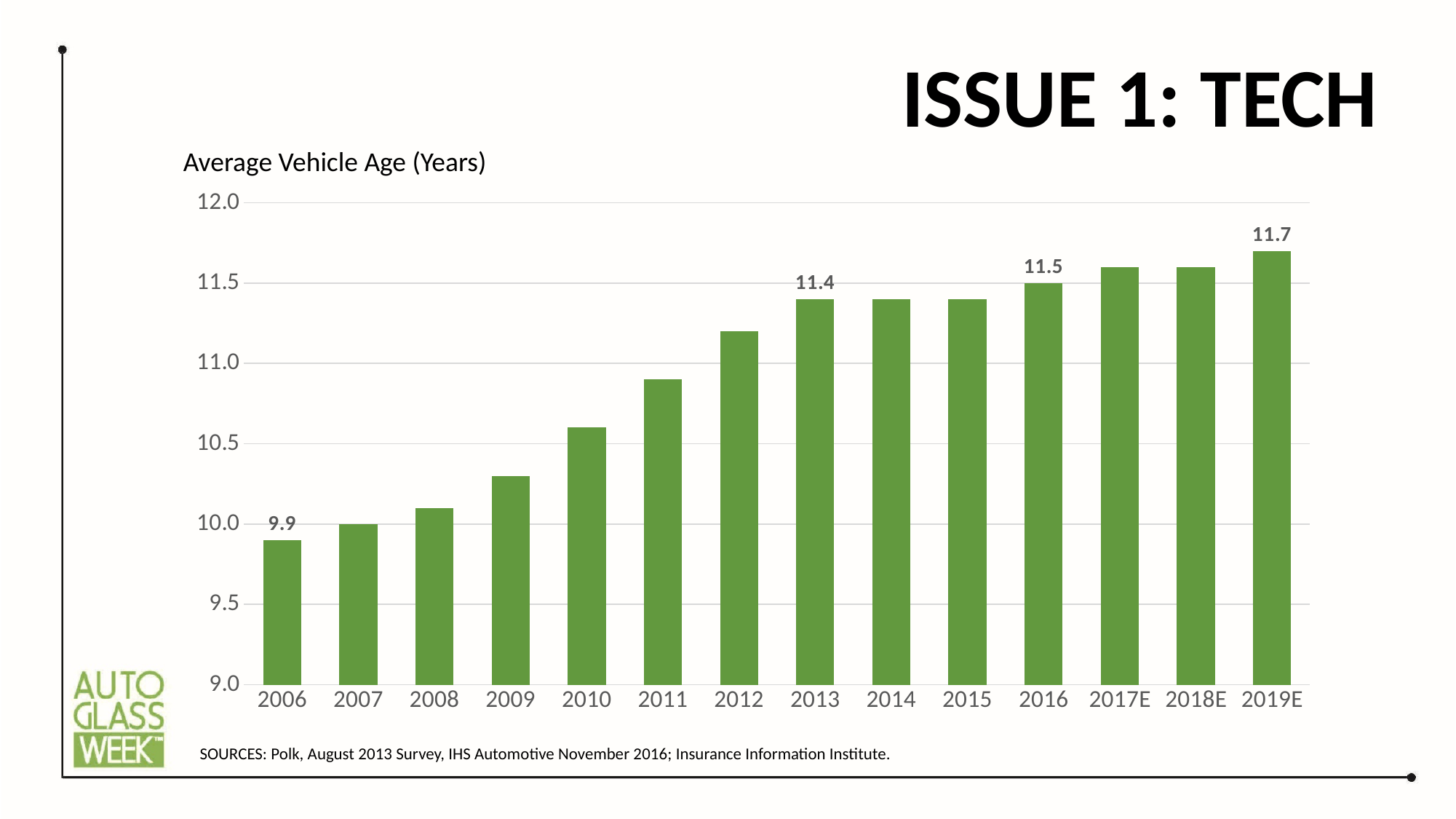
What is the difference between the average vehicle age in 2019E and in 2006? 1.8 Which is larger, the average vehicle age in 2016 or in 2013? 2016 Which year has the lowest average vehicle age? 2006 What is the average vehicle age shown for 2006? 9.9 What is the average vehicle age shown for 2019E? 11.7 Which year has the highest average vehicle age? 2019E Is the value for 2010 greater or less than 11.0? less Do the values generally rise or fall from 2006 to 2019E? rise What is the average vehicle age shown for 2016? 11.5 What is the average vehicle age shown for 2013? 11.4 How many years are shown on the x axis? 14 What kind of chart is shown on the slide? bar chart